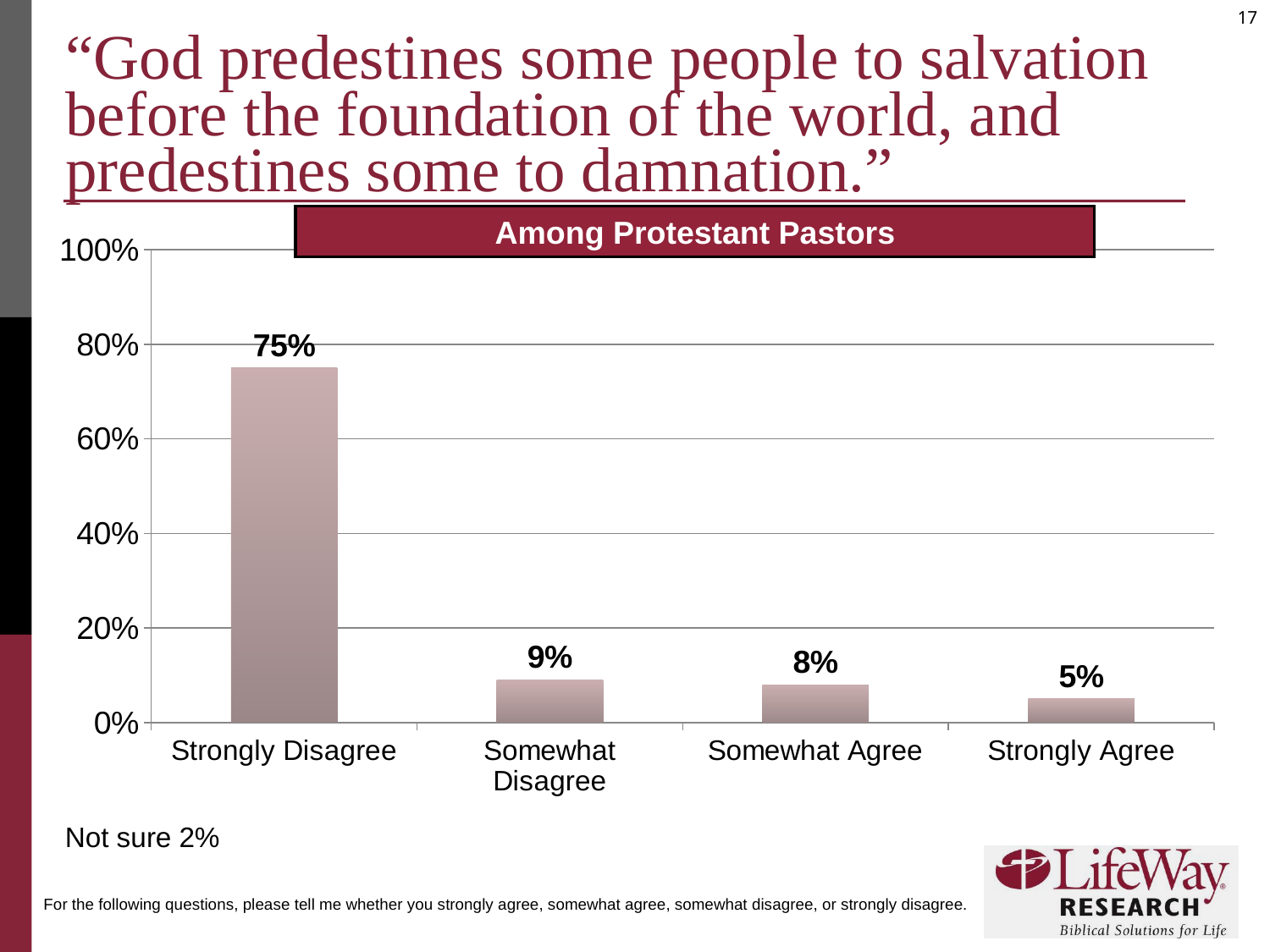
What is the difference between the Somewhat Agree and Strongly Agree values? 3% Which response category has the highest value? Strongly Disagree What percentage of Protestant pastors strongly agree with the statement? 5% What percentage of Protestant pastors strongly disagree with the statement? 75% Which is larger, the value for Somewhat Disagree or the value for Somewhat Agree? Somewhat Disagree What is the difference between the Strongly Disagree and Somewhat Disagree values? 66% Which response category has the lowest value among the plotted bars? Strongly Agree What percentage of Protestant pastors somewhat agree with the statement? 8% What kind of chart is shown on the slide? Bar chart What percentage of Protestant pastors somewhat disagree with the statement? 9% What group of respondents does the chart cover, according to the label above the chart? Protestant Pastors How many response categories are plotted as bars in the chart? 4